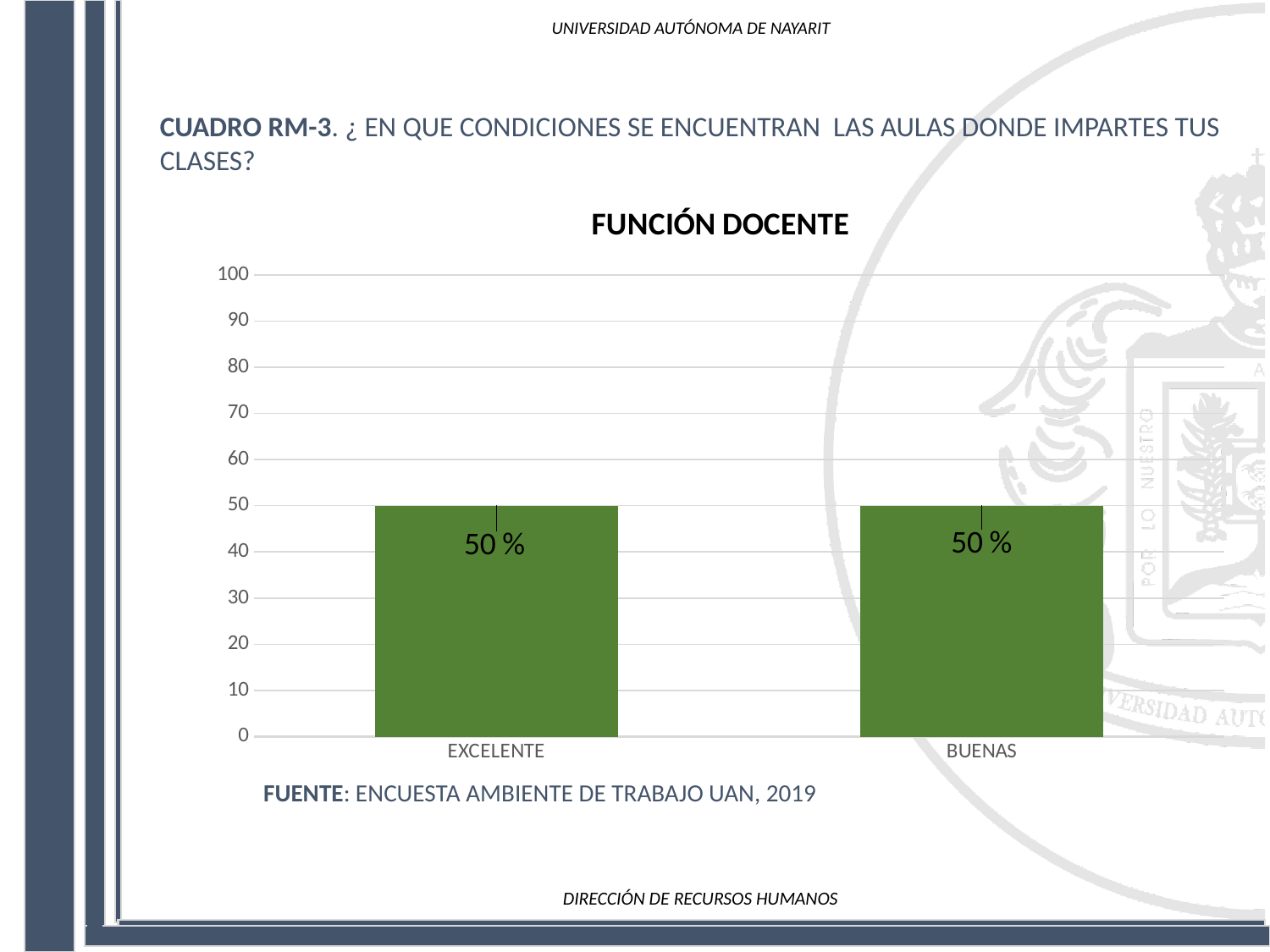
What is the difference between the values for EXCELENTE and BUENAS? 0 What is the value for BUENAS? 50 % Is the value for BUENAS greater or less than 20? greater What kind of chart is shown on the slide? bar chart What is the title of the chart? FUNCIÓN DOCENTE What is the value for EXCELENTE? 50 % What is the total of the values for EXCELENTE and BUENAS? 100 % What is the highest value shown on the y axis? 100 How many categories are shown on the x axis? 2 Is the value for EXCELENTE greater or less than 80? less